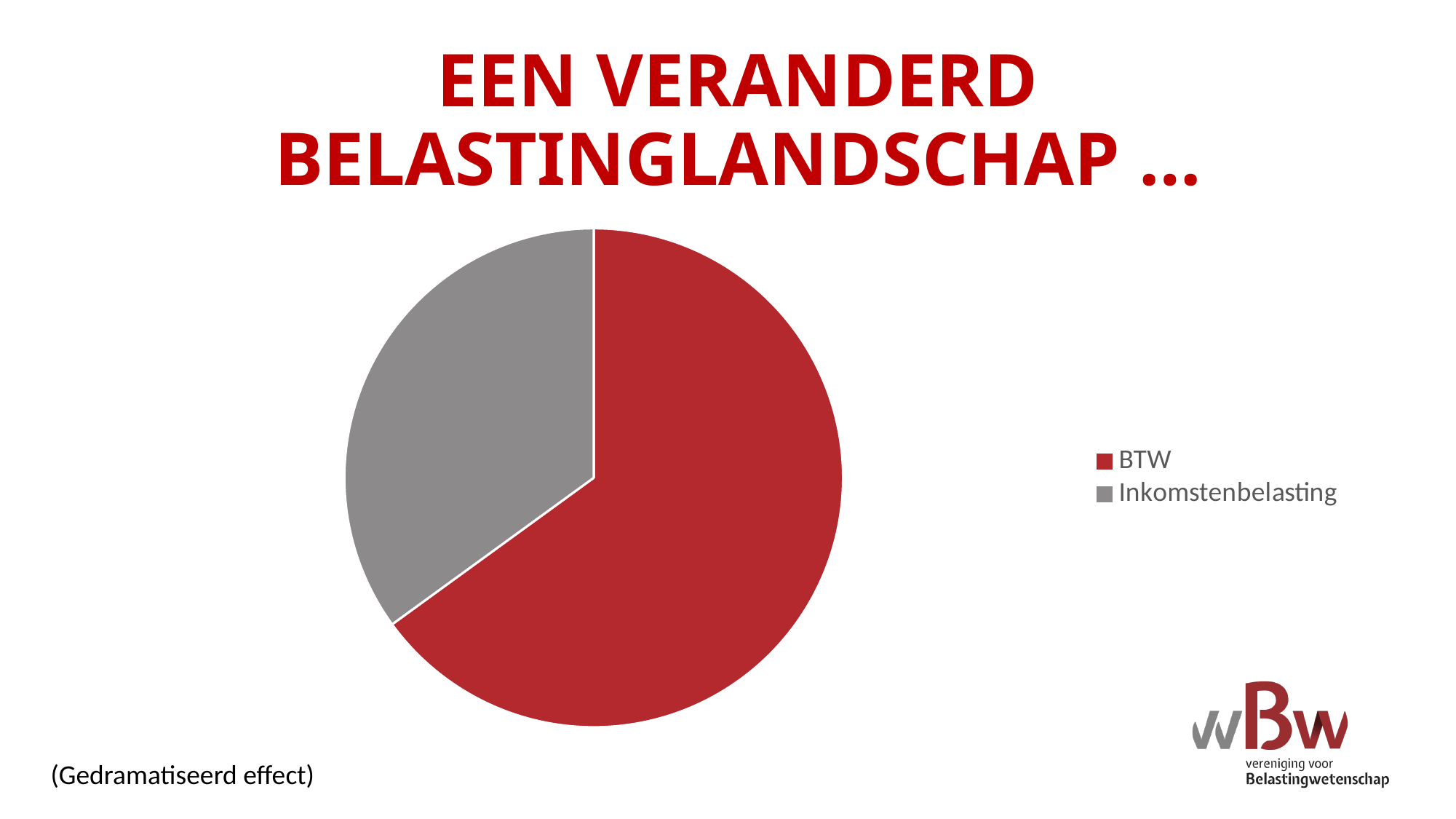
Which is larger in the pie chart, BTW or Inkomstenbelasting? BTW Which slice of the pie chart is the largest? BTW What colour is the Inkomstenbelasting slice in the pie chart? grey What kind of chart is shown on the slide? pie chart How many slices does the pie chart have? 2 What colour is the BTW slice in the pie chart? red Which slice of the pie chart is the smallest? Inkomstenbelasting How many entries does the legend of the pie chart list? 2